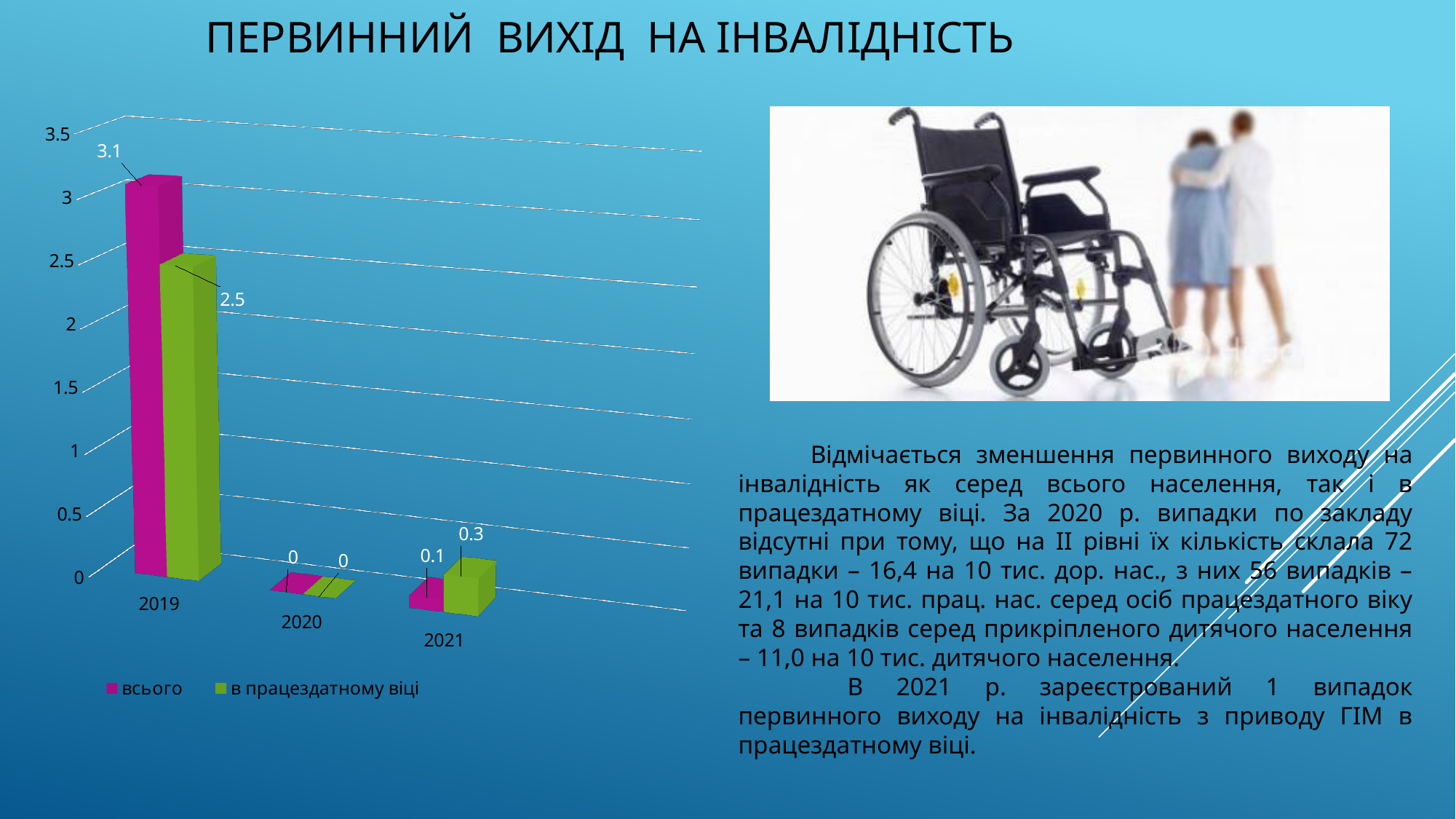
In which year is the value for "всього" highest? 2019 What is the value for "всього" in 2021? 0.1 What is the value for "в працездатному віці" in 2021? 0.3 In which year is the value for "в працездатному віці" lowest? 2020 What is the value for "всього" in 2020? 0 What is the difference between the "всього" and "в працездатному віці" values in 2019? 0.6 How many years are shown on the x axis of the chart? 3 What is the value for "в працездатному віці" in 2019? 2.5 What kind of chart is shown on the slide? bar chart In 2021, which series has the larger value, "всього" or "в працездатному віці"? в працездатному віці How many series does the chart legend list? 2 What is the value for "всього" in 2019? 3.1